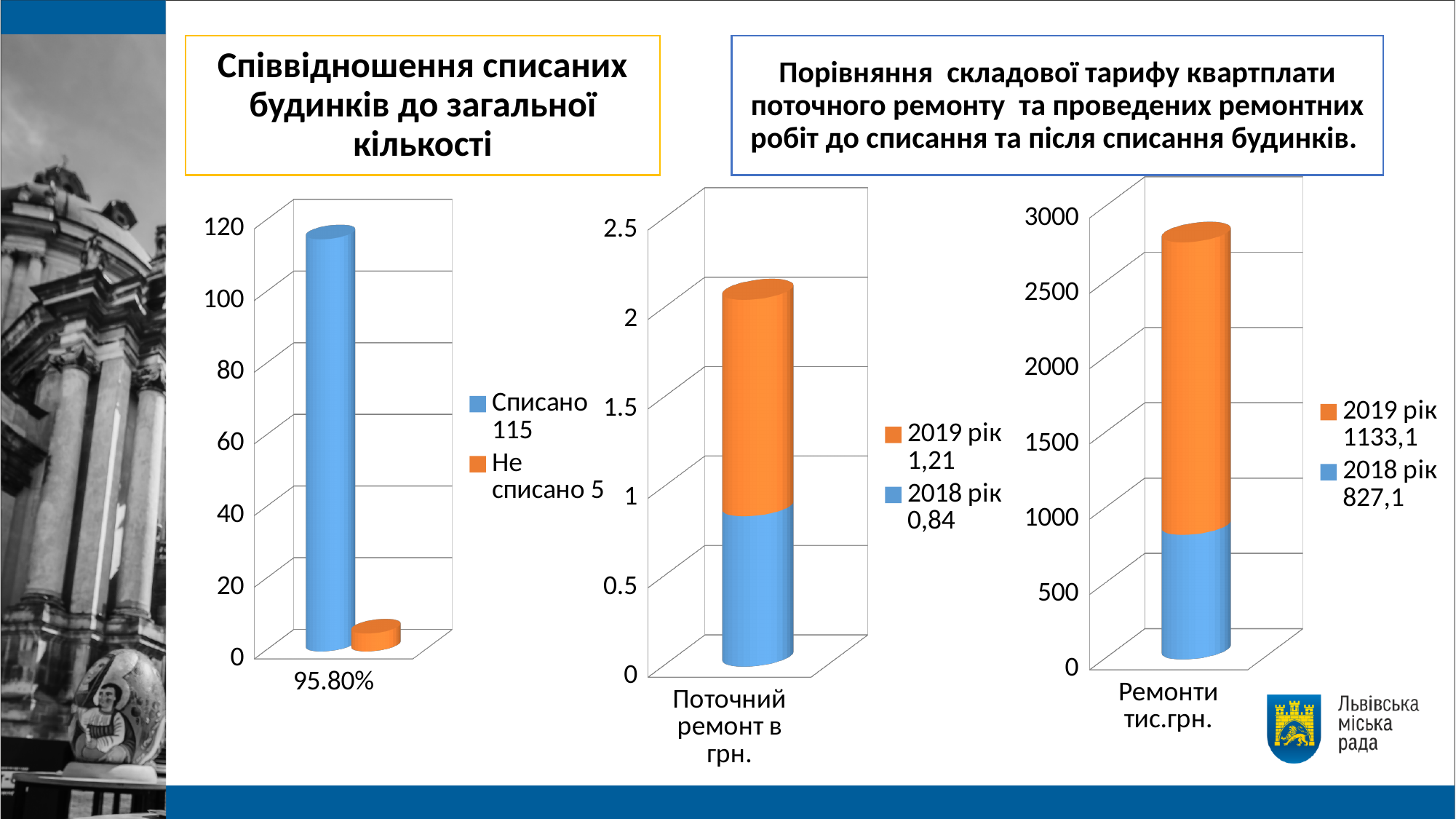
On the middle chart ('Поточний ремонт в грн.'), what is the value for 2019 рік? 1,21 On the middle chart ('Поточний ремонт в грн.'), how many series does the legend list? 2 On the left chart titled 'Співвідношення списаних будинків до загальної кількості', what value is given for 'Списано'? 115 On the right chart ('Ремонти тис.грн.'), what is the value for 2019 рік? 1133,1 On the left chart, what category label is shown on the x axis? 95.80% On the right chart ('Ремонти тис.грн.'), which year has the larger value, 2018 рік or 2019 рік? 2019 рік On the left chart, which series is larger, 'Списано' or 'Не списано'? Списано On the middle chart ('Поточний ремонт в грн.'), what is the value for 2018 рік? 0,84 On the right chart ('Ремонти тис.грн.'), what is the value for 2018 рік? 827,1 On the left chart titled 'Співвідношення списаних будинків до загальної кількості', what value is given for 'Не списано'? 5 On the left chart, what is the difference between the 'Списано' and 'Не списано' values? 110 On the middle chart ('Поточний ремонт в грн.'), is the total height of the stacked bar greater or less than 1.5? greater